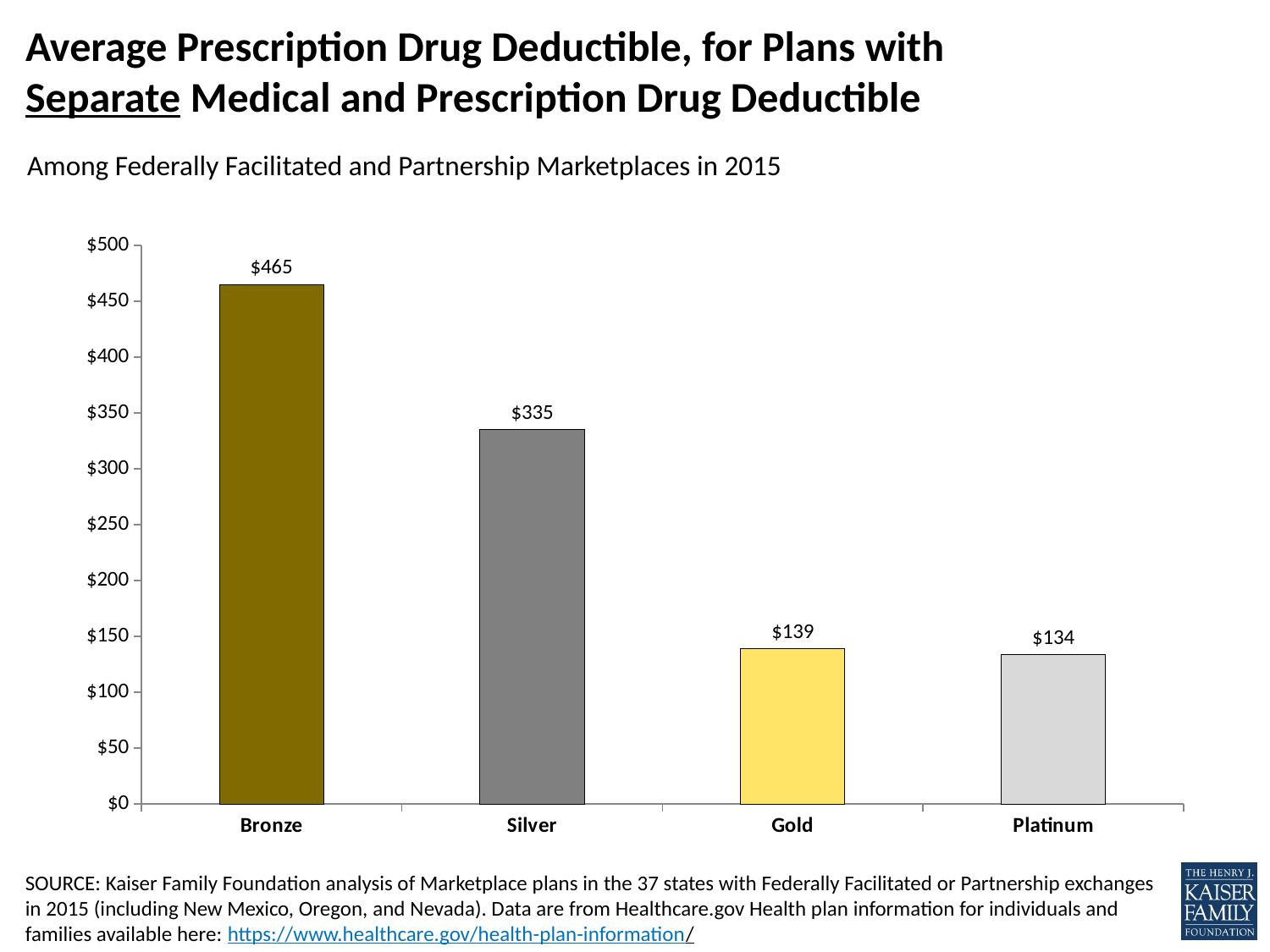
Which plan tier has the highest average prescription drug deductible? Bronze What is the difference between the Gold and Platinum average prescription drug deductibles? $5 Which has a larger average prescription drug deductible, Silver or Gold? Silver What is the average prescription drug deductible for Gold plans? $139 Which plan tier has the lowest average prescription drug deductible? Platinum What is the difference between the Bronze and Silver average prescription drug deductibles? $130 What is the average prescription drug deductible for Bronze plans? $465 What is the average prescription drug deductible for Platinum plans? $134 What is the average prescription drug deductible for Silver plans? $335 How many plan tiers are shown in the chart? 4 What kind of chart is shown on the slide? Bar chart Do the values rise or fall moving from Bronze to Platinum along the x axis? Fall